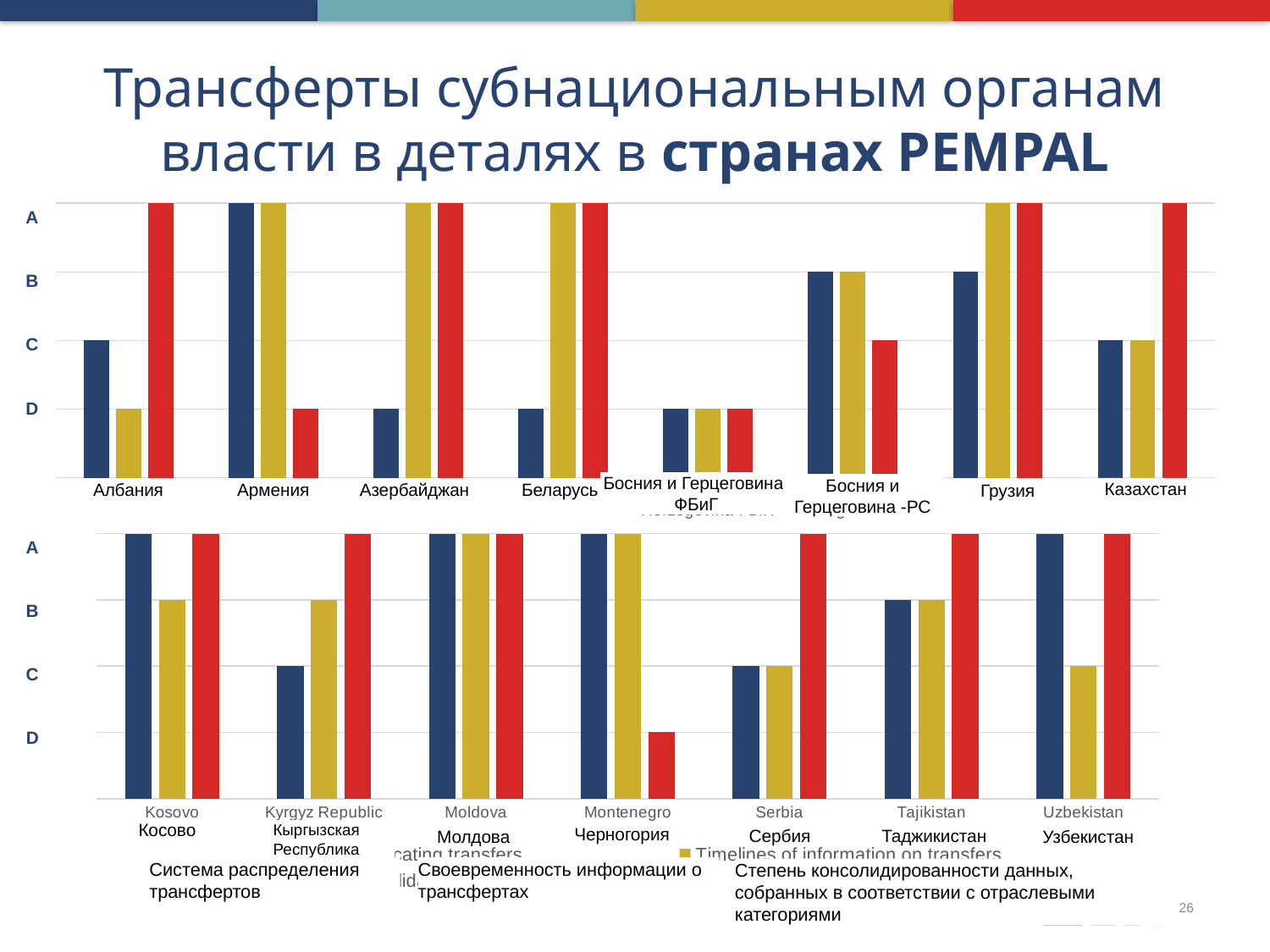
On the bottom chart, what grade does the red series show for Черногория? D How many countries are shown on the top chart? 8 On the top chart, what grade does the yellow series (Своевременность информации о трансфертах) show for Казахстан? C On the top chart, what grade does the blue series (Система распределения трансфертов) show for Албания? C On the bottom chart, what grade does the blue series show for Кыргызская Республика? C On the bottom chart, what grade does the yellow series show for Узбекистан? C On the bottom chart, which country has all three series at grade A? Молдова On the top chart, what grade do all three series show for Босния и Герцеговина ФБиГ? D What kind of chart is used on this slide? Bar chart On the top chart, what grade does the red series (Степень консолидированности данных) show for Армения? D How many countries are shown on the bottom chart? 7